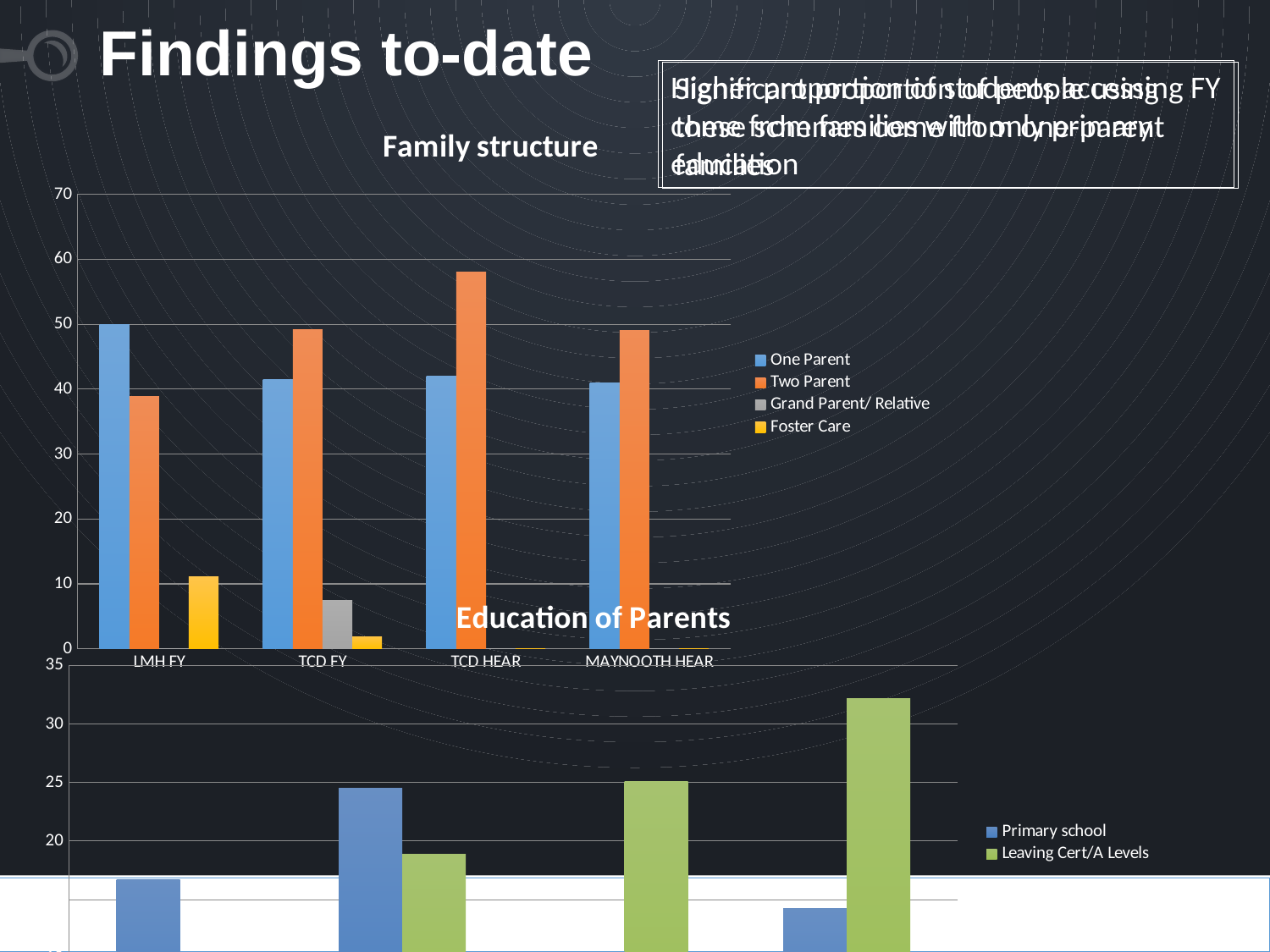
On the Family structure chart, for TCD HEAR, which is larger: One Parent or Two Parent? Two Parent On the Family structure chart, is the Two Parent value for TCD HEAR greater or less than 50? greater On the Family structure chart, what kind of chart is it? bar chart On the Family structure chart, is the Foster Care value for LMH FY greater or less than 10? greater On the Family structure chart, how many series does the legend list? 4 On the Family structure chart, for LMH FY, which is larger: One Parent or Two Parent? One Parent On the Family structure chart, how many categories are shown on the x axis? 4 On the Family structure chart, what is the One Parent value for LMH FY? 50 On the Family structure chart, which category has the highest One Parent value? LMH FY On the Education of Parents chart, how many series does the legend list? 2 On the Family structure chart, which category has the highest Two Parent value? TCD HEAR On the Family structure chart, what colour represents Foster Care in the legend? yellow